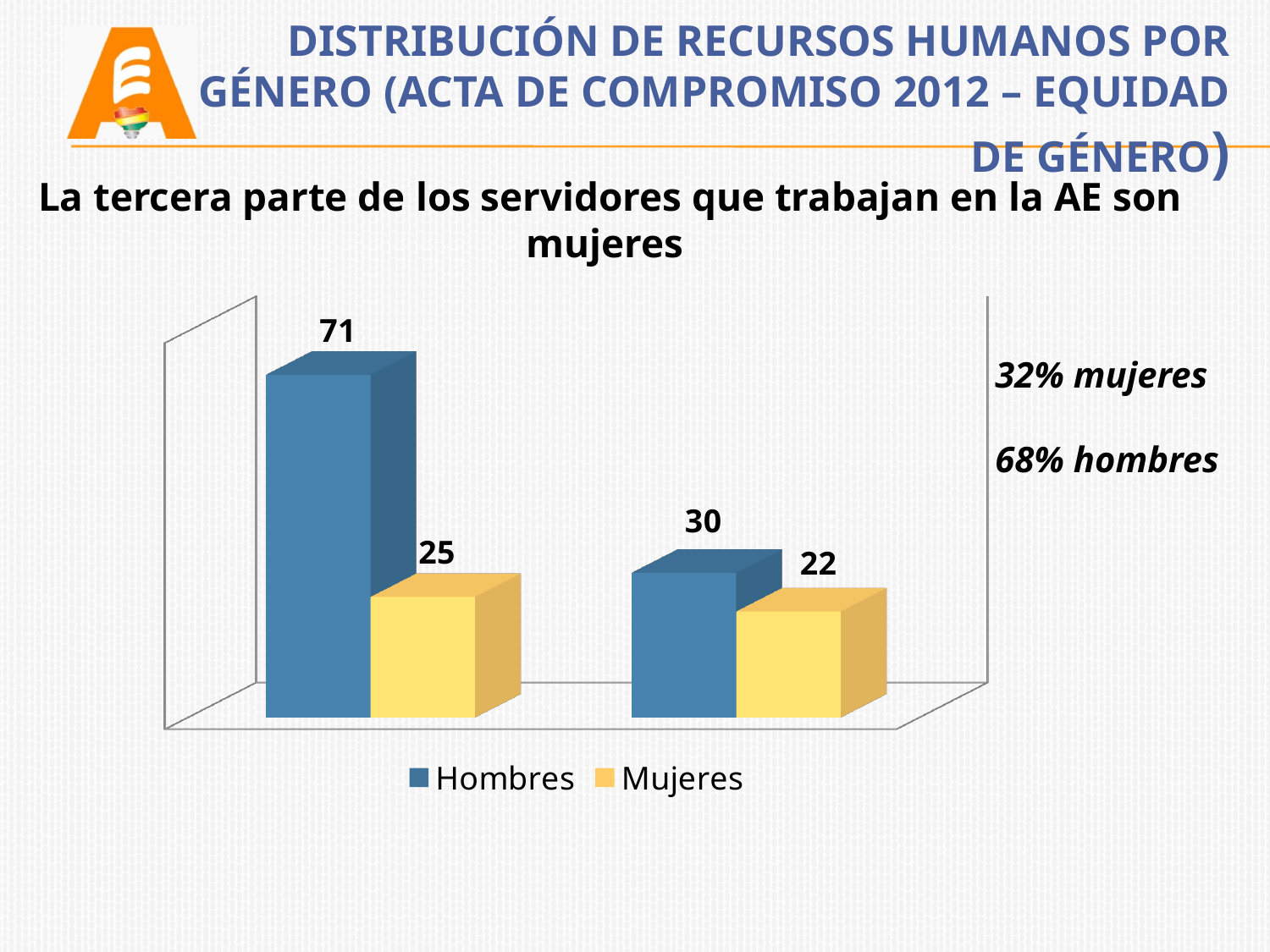
What is the value of the Mujeres bar in the right group of bars? 22 What is the difference between the Hombres and Mujeres values in the right group of bars? 8 Which bar has the lowest value in the chart? Mujeres in the right group (22) What are the two series named in the chart legend? Hombres and Mujeres What is the difference between the Hombres and Mujeres values in the left group of bars? 46 What is the value of the Hombres bar in the left group of bars? 71 What kind of chart is shown on the slide? bar chart Which bar has the highest value in the chart? Hombres in the left group (71) What is the value of the Hombres bar in the right group of bars? 30 How many series does the chart legend list? 2 What is the value of the Mujeres bar in the left group of bars? 25 Which is larger: the Mujeres value in the left group or the Hombres value in the right group? Hombres in the right group (30)